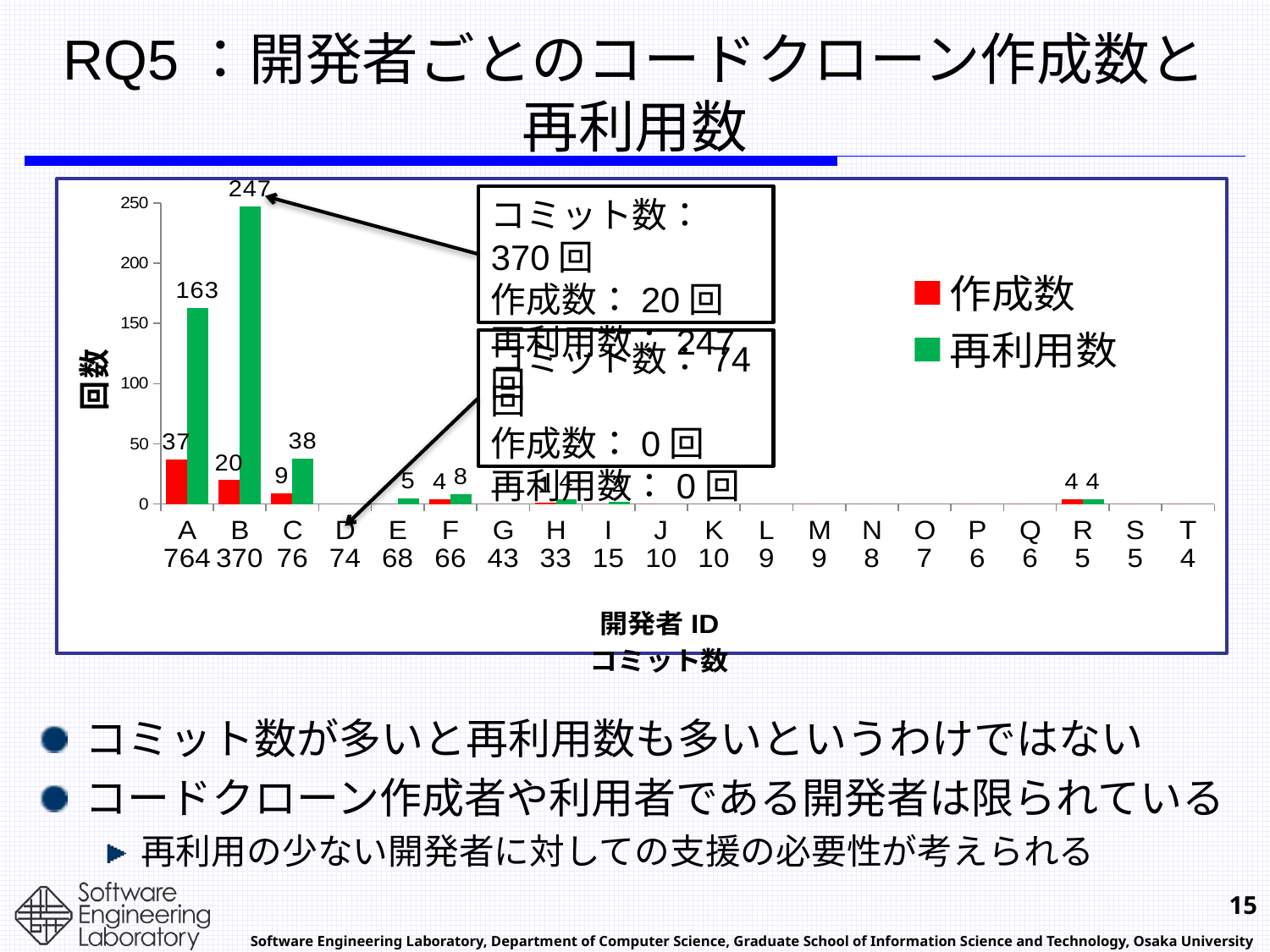
Which is larger, the 作成数 of developer B or the 作成数 of developer C? developer B What is the commit count (コミット数) shown under developer A? 764 What kind of chart is shown on the slide? bar chart How many series does the legend list? 2 What is the 再利用数 value for developer C? 38 What is the 再利用数 value for developer B? 247 What is the difference between the 再利用数 of developer B and developer A? 84 How many developer IDs are shown on the x axis? 20 Which developer has the highest 作成数? A Which developer has the highest 再利用数? B What are the two series named in the legend? 作成数 and 再利用数 What is the 作成数 value for developer A? 37